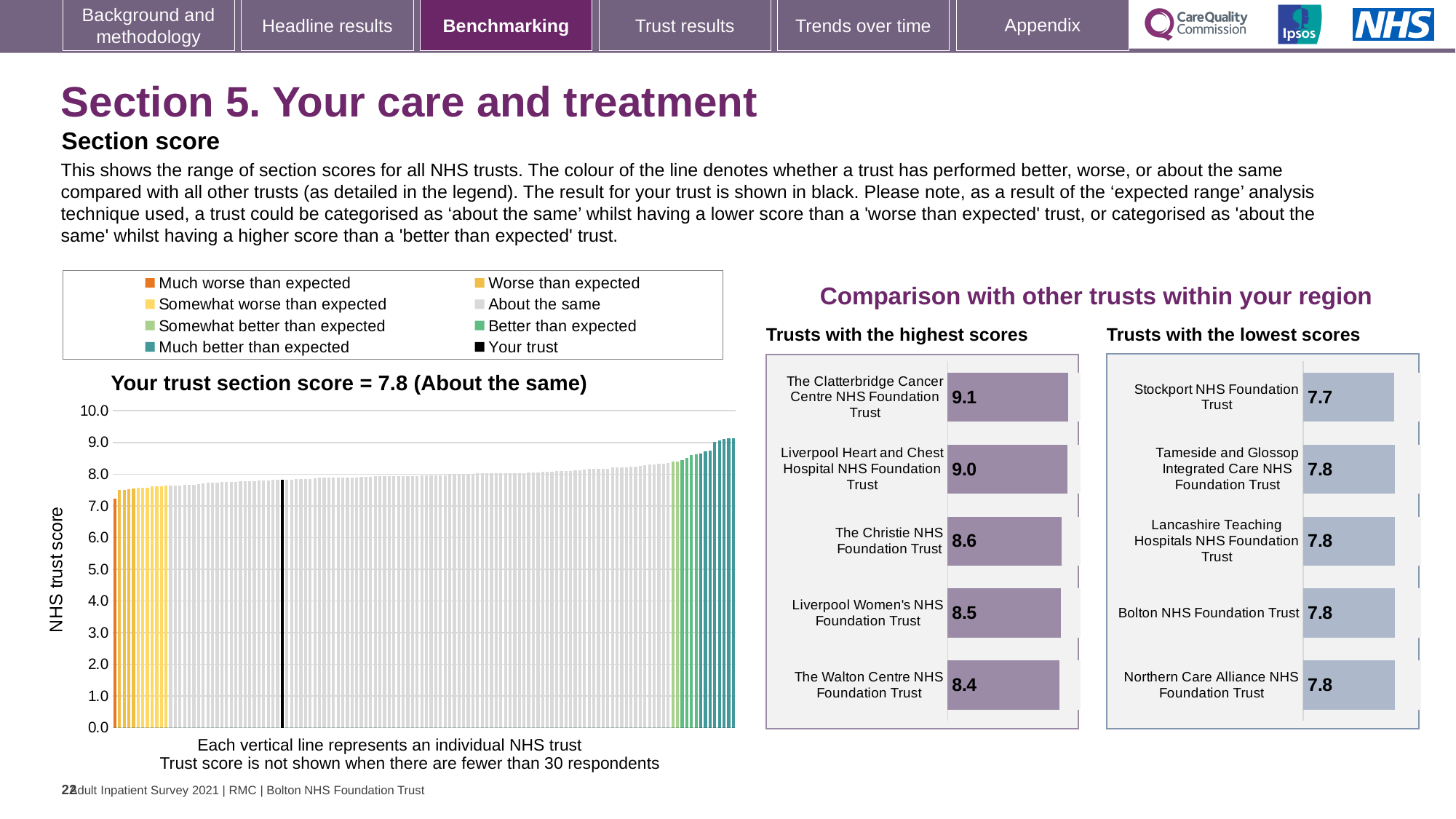
How many entries does the legend above the main chart on the left list? 8 In the 'Trusts with the lowest scores' chart, what is the score for Stockport NHS Foundation Trust? 7.7 In the 'Trusts with the lowest scores' chart, which trust has the lowest score? Stockport NHS Foundation Trust In the 'Trusts with the highest scores' chart, which trust has the highest score? The Clatterbridge Cancer Centre NHS Foundation Trust In the 'Trusts with the highest scores' chart, what is the difference between the scores of The Clatterbridge Cancer Centre NHS Foundation Trust and The Walton Centre NHS Foundation Trust? 0.7 In the 'Trusts with the highest scores' chart, what is the score for The Walton Centre NHS Foundation Trust? 8.4 According to the title of the main chart on the left, what is your trust's section score? 7.8 (About the same) How many trusts are shown in the 'Trusts with the highest scores' chart? 5 In the main chart on the left, is the lowest trust score greater or less than 8.0? less In the 'Trusts with the highest scores' chart, what is the score for The Clatterbridge Cancer Centre NHS Foundation Trust? 9.1 What kind of chart is the 'Trusts with the lowest scores' chart? Bar chart In the 'Trusts with the highest scores' chart, which has the higher score: The Christie NHS Foundation Trust or Liverpool Women's NHS Foundation Trust? The Christie NHS Foundation Trust